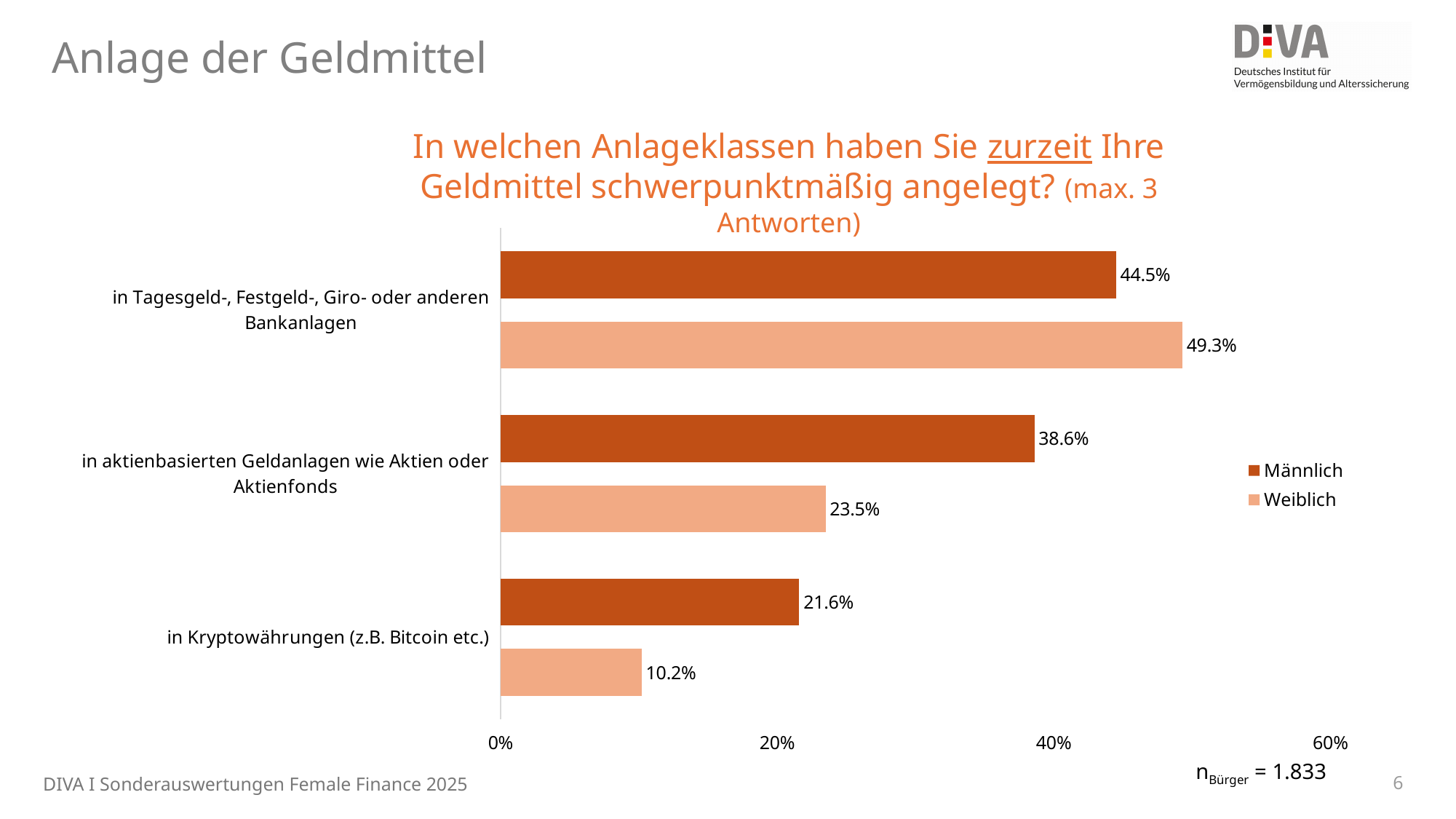
How many categories are shown on the chart? 3 Which is larger for 'in Tagesgeld-, Festgeld-, Giro- oder anderen Bankanlagen': the Männlich value or the Weiblich value? Weiblich What is the value for Männlich in the category 'in Tagesgeld-, Festgeld-, Giro- oder anderen Bankanlagen'? 44.5% Which category has the highest value for Weiblich? in Tagesgeld-, Festgeld-, Giro- oder anderen Bankanlagen What is the difference between the Männlich and Weiblich values for 'in aktienbasierten Geldanlagen wie Aktien oder Aktienfonds'? 15.1% Is the Männlich value for 'in Kryptowährungen (z.B. Bitcoin etc.)' greater or less than 20%? greater What is the value for Weiblich in the category 'in Kryptowährungen (z.B. Bitcoin etc.)'? 10.2% What is the value for Weiblich in the category 'in aktienbasierten Geldanlagen wie Aktien oder Aktienfonds'? 23.5% What kind of chart is shown on the slide? bar chart Which category has the lowest value for Männlich? in Kryptowährungen (z.B. Bitcoin etc.) How many series does the legend list? 2 Which series is shown in the darker orange colour? Männlich